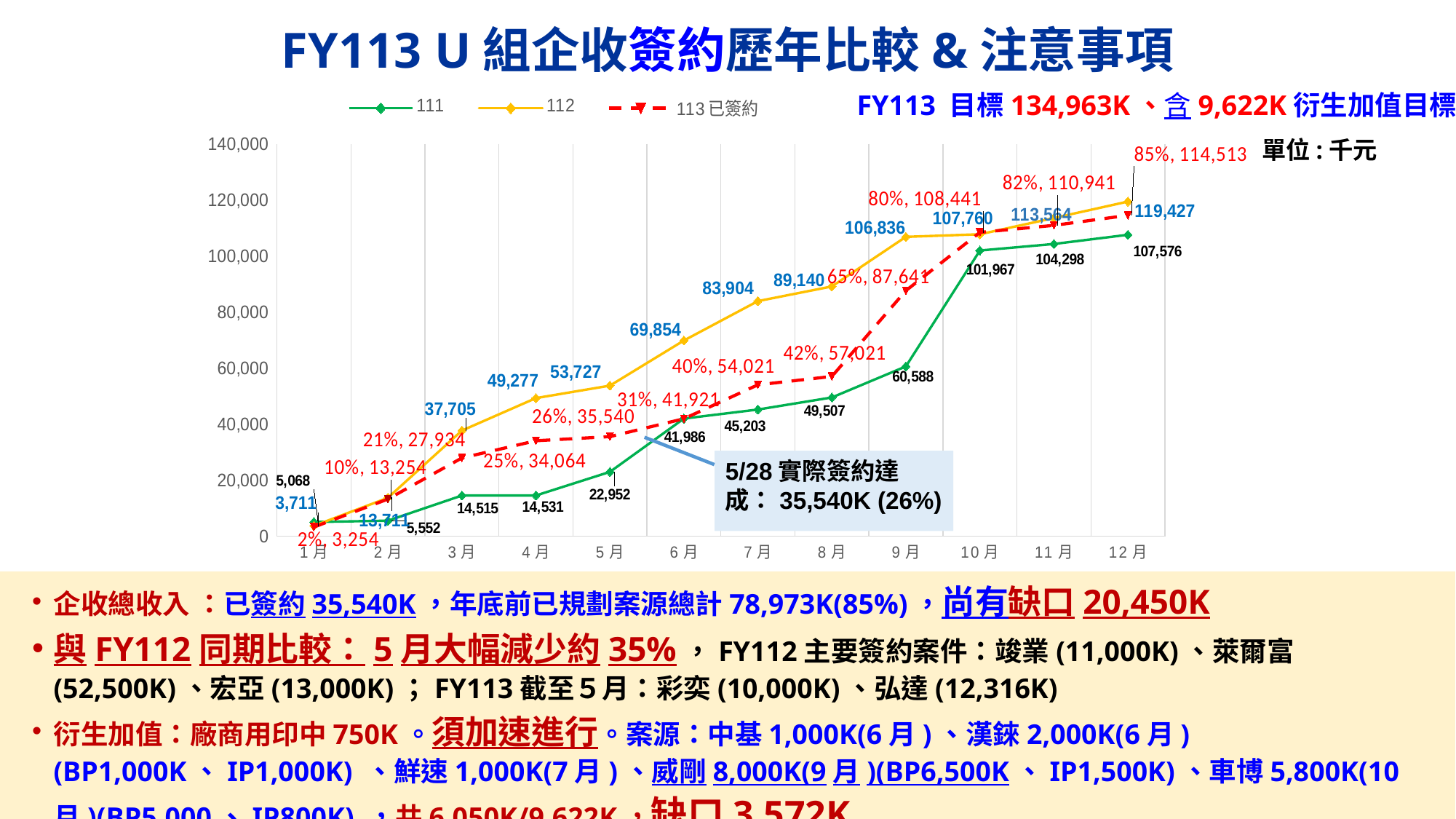
What kind of chart is shown on the slide? line chart What is the value of the 111 series in 9月? 60,588 Is the value of the 112 series in 7月 greater or less than 80,000? greater Does the 111 series rise or fall from 1月 to 12月? rise What percentage is shown for the 113 已簽約 series in 9月? 65% How many series does the chart legend list? 3 What is the value of the 113 已簽約 series in 5月? 35,540 In 6月, which series has the larger value, 111 or 112? 112 How many months are shown along the x axis of the chart? 12 What is the value of the 112 series in 12月? 119,427 What is the difference between the 112 and 111 values in 12月? 11,851 In which month does the 112 series reach its highest value? 12月